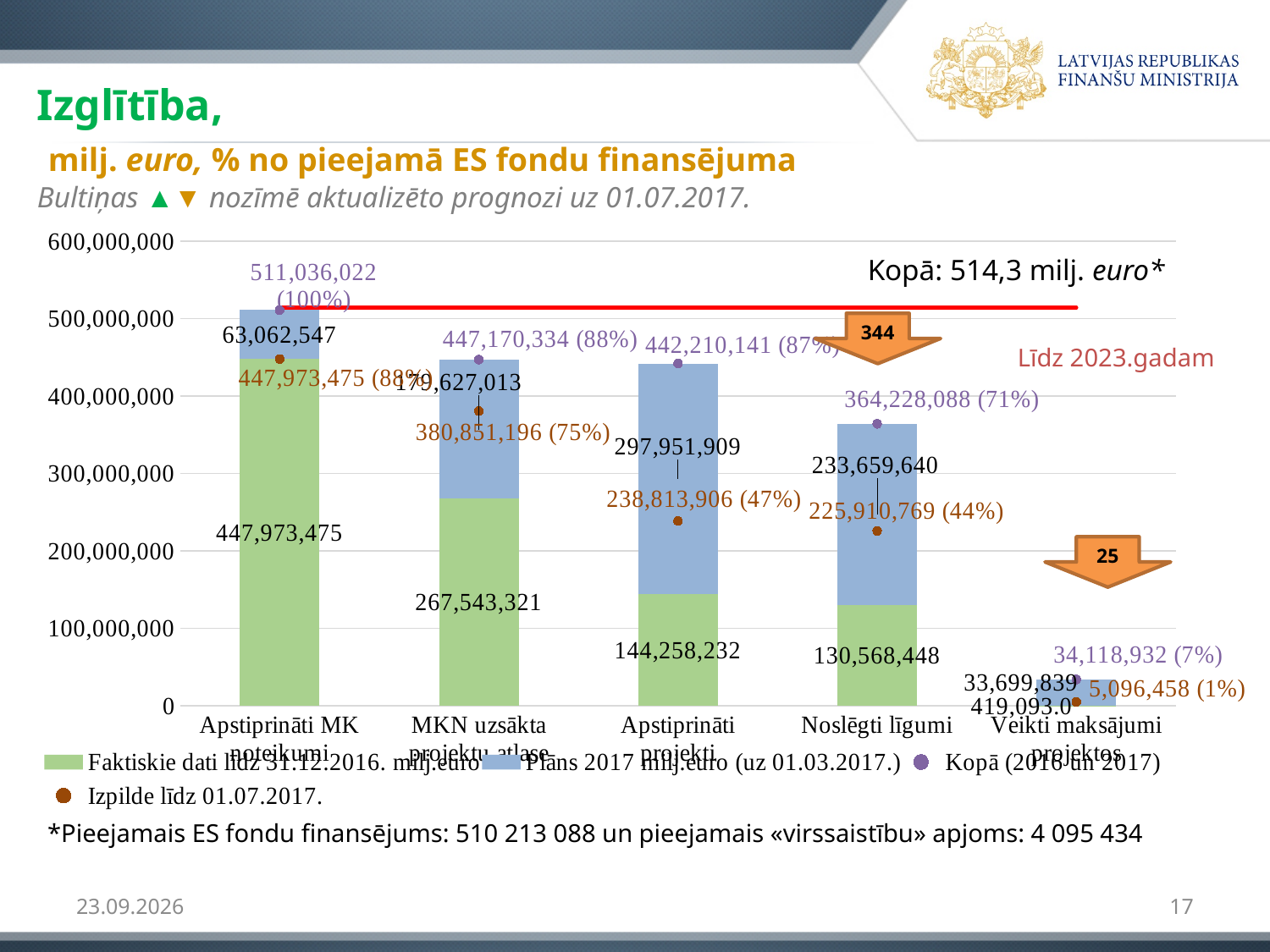
What is the value of 'Faktiskie dati līdz 31.12.2016.' for 'Apstiprināti projekti'? 144,258,232 What is the difference between the 'Faktiskie dati līdz 31.12.2016.' values for 'Apstiprināti projekti' and 'Noslēgti līgumi'? 13,689,784 How many categories are shown on the x axis of the chart? 5 What is the 'Izpilde līdz 01.07.2017.' label shown for 'Apstiprināti projekti'? 238,813,906 (47%) Which has the larger 'Plāns 2017' value: 'Apstiprināti projekti' or 'Noslēgti līgumi'? Apstiprināti projekti What is the value of 'Plāns 2017' for 'Noslēgti līgumi'? 233,659,640 What kind of chart is shown on the slide? bar chart How many series does the chart legend list? 4 Which category has the highest 'Kopā (2016 un 2017)' value? Apstiprināti MK noteikumi What is the total of the stacked bar for 'Noslēgti līgumi'? 364,228,088 What is the 'Kopā (2016 un 2017)' label shown for 'Noslēgti līgumi'? 364,228,088 (71%) Which category has the lowest 'Faktiskie dati līdz 31.12.2016.' value? Veikti maksājumi projektos